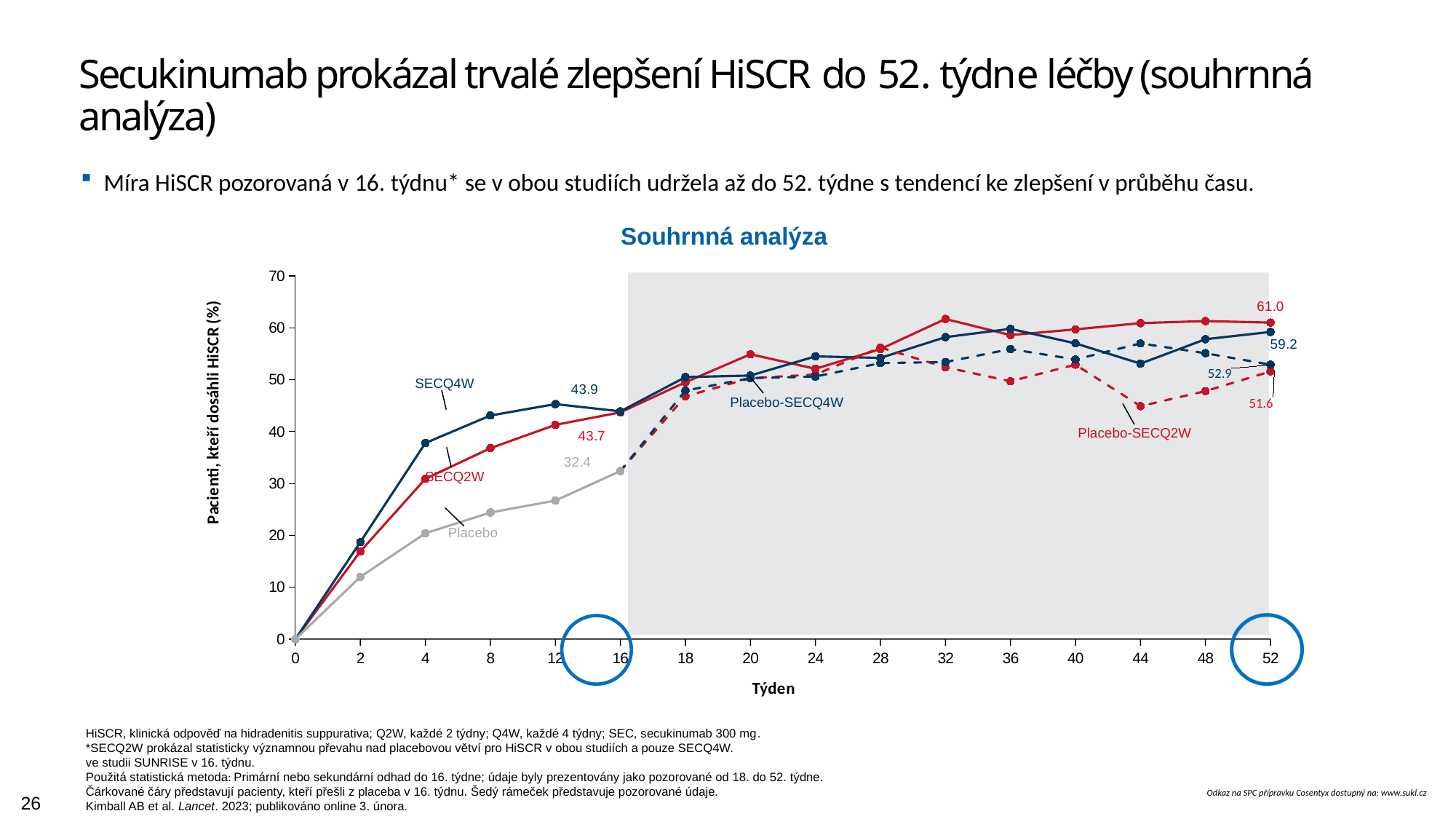
What is the value for Placebo at week 16? 32.4 What is the difference between the SECQ4W and Placebo values at week 16? 11.5 What kind of chart is shown on the slide? line chart At week 52, which is larger: Placebo-SECQ4W or Placebo-SECQ2W? Placebo-SECQ4W What is the value for SECQ4W at week 52? 59.2 Is the value for Placebo at week 8 greater or less than 30? less What is the difference between the SECQ2W and SECQ4W values at week 52? 1.8 Which series has the lowest labelled value at week 16? Placebo What is the value for SECQ2W at week 52? 61.0 Which series has the highest labelled value at week 52? SECQ2W What is the value for SECQ4W at week 16? 43.9 What is the value for Placebo-SECQ2W at week 52? 51.6